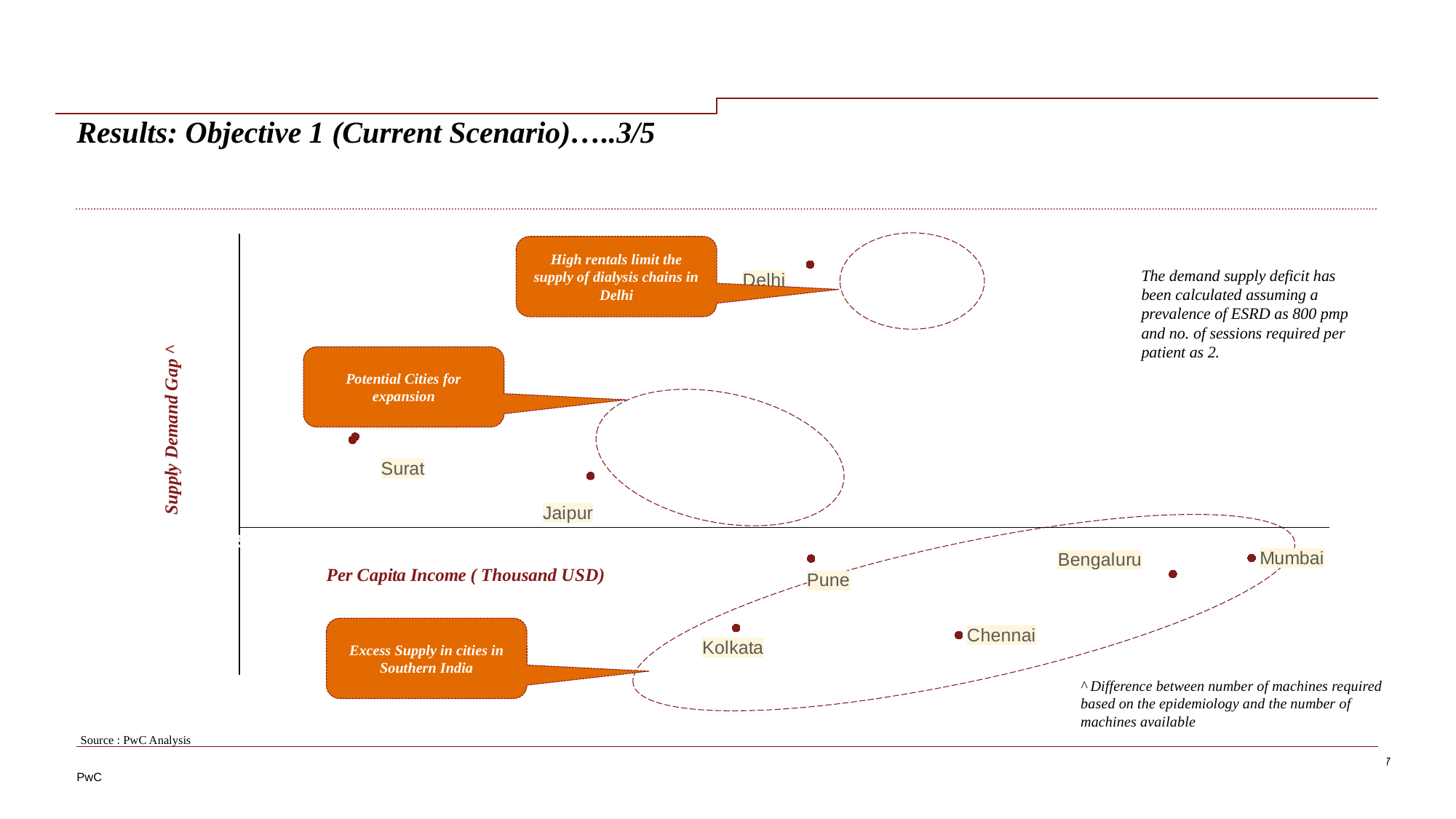
What kind of chart is shown on the slide? Scatter chart What is the label of the horizontal axis of the chart? Per Capita Income ( Thousand USD) How many cities are plotted above the horizontal axis line (positive Supply Demand Gap)? 3 Which city has a higher Supply Demand Gap, Delhi or Surat? Delhi What is the label of the vertical axis of the chart? Supply Demand Gap ^ How many cities are plotted on the chart? 8 Which city is plotted furthest to the right, i.e. has the highest Per Capita Income? Mumbai Which city is plotted furthest to the left, i.e. has the lowest Per Capita Income? Surat Which city has a higher Per Capita Income, Mumbai or Kolkata? Mumbai How many cities are plotted below the horizontal axis line (excess supply)? 5 Which city has a higher Supply Demand Gap, Jaipur or Pune? Jaipur Which city has the highest Supply Demand Gap on the chart? Delhi